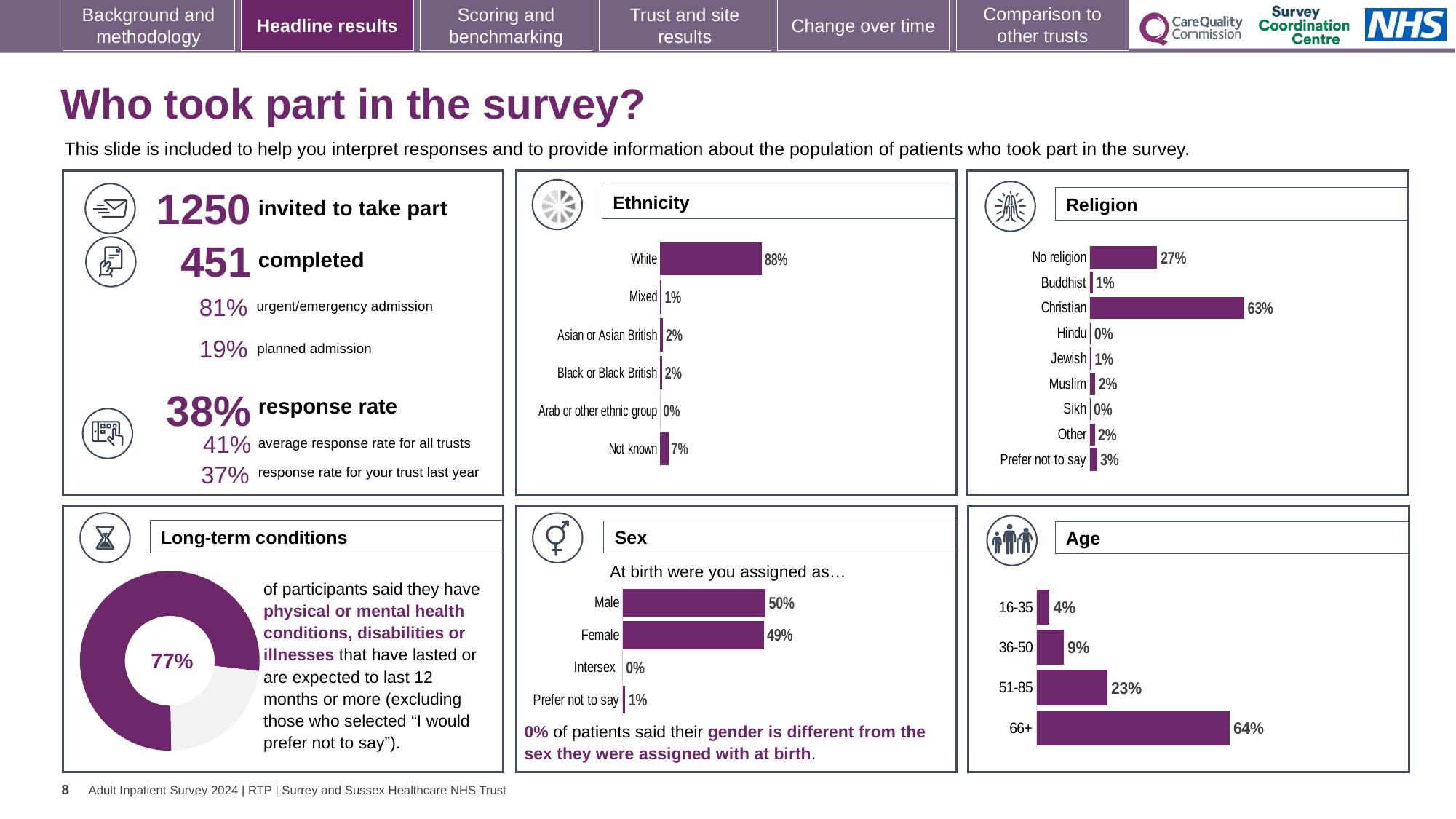
In the Ethnicity chart, what percentage of respondents were White? 88% What kind of chart is the Long-term conditions chart? Donut chart In the Long-term conditions chart, what share of participants said they have a long-term condition? 77% In the Sex chart, what percentage of respondents selected Prefer not to say? 1% How many categories are shown in the Religion chart? 9 In the Age chart, do the values rise or fall as the age groups get older? Rise In the Ethnicity chart, which category has the highest value? White How many categories are shown in the Ethnicity chart? 6 In the Sex chart, which is larger, Male or Female? Male In the Age chart, which age group has the highest value? 66+ In the Religion chart, what percentage of respondents were Christian? 63% In the Religion chart, what is the difference between the Christian and No religion values? 36%